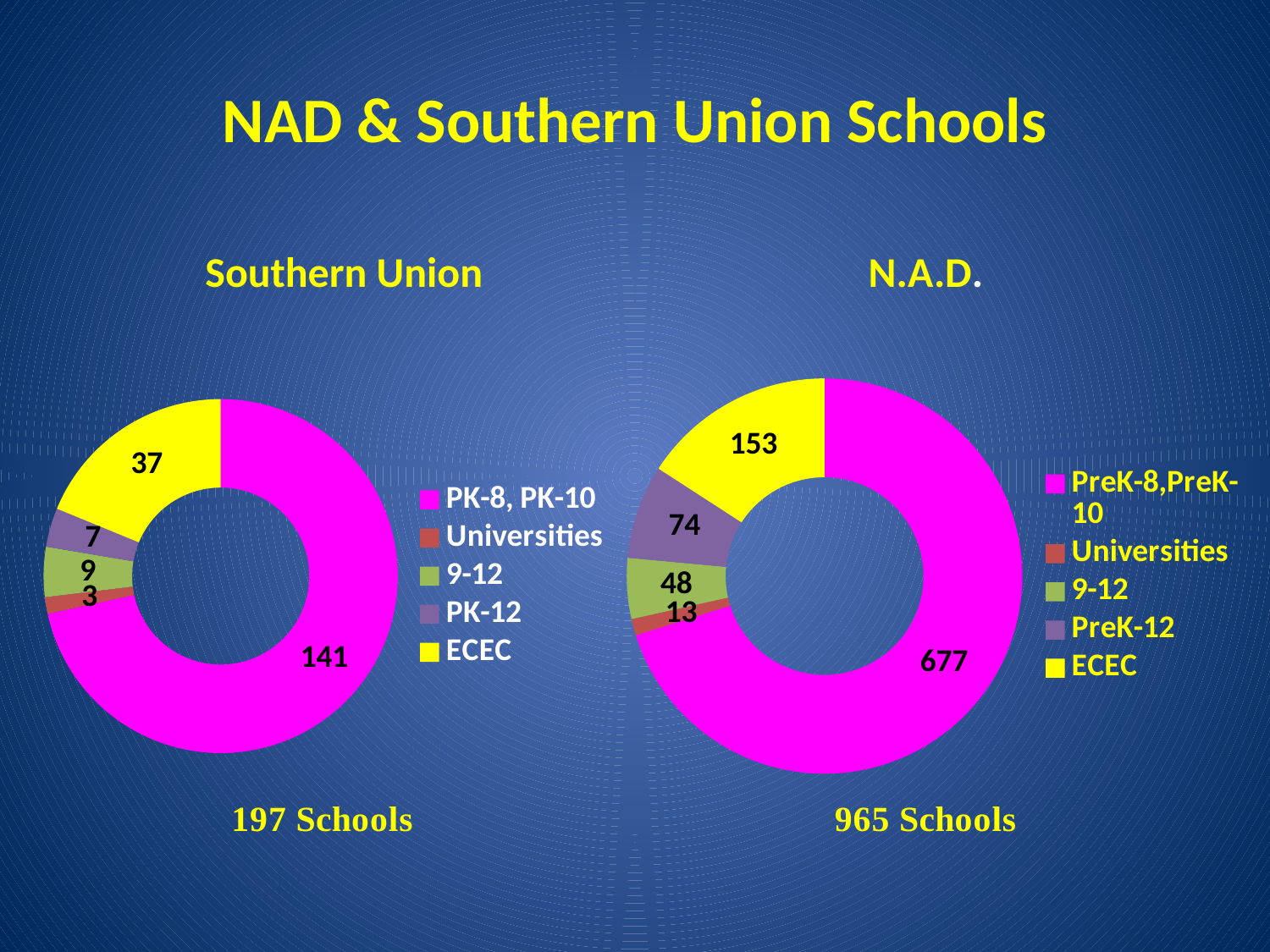
In the Southern Union chart, which category has the smallest value? Universities In the N.A.D. chart, what is the value for Universities? 13 In the N.A.D. chart, what is the difference between the ECEC value and the PreK-12 value? 79 In the Southern Union chart, which is larger: 9-12 or PK-12? 9-12 In the Southern Union chart, what is the value for PK-12? 7 What total number of schools is shown below the N.A.D. chart? 965 Schools How many categories does the N.A.D. chart show? 5 What kind of chart is the Southern Union chart? doughnut chart In the N.A.D. chart, which category has the largest value? PreK-8,PreK-10 What colour represents ECEC in both charts? yellow In the N.A.D. chart, what is the value for ECEC? 153 In the Southern Union chart, how many schools are in the PK-8, PK-10 category? 141